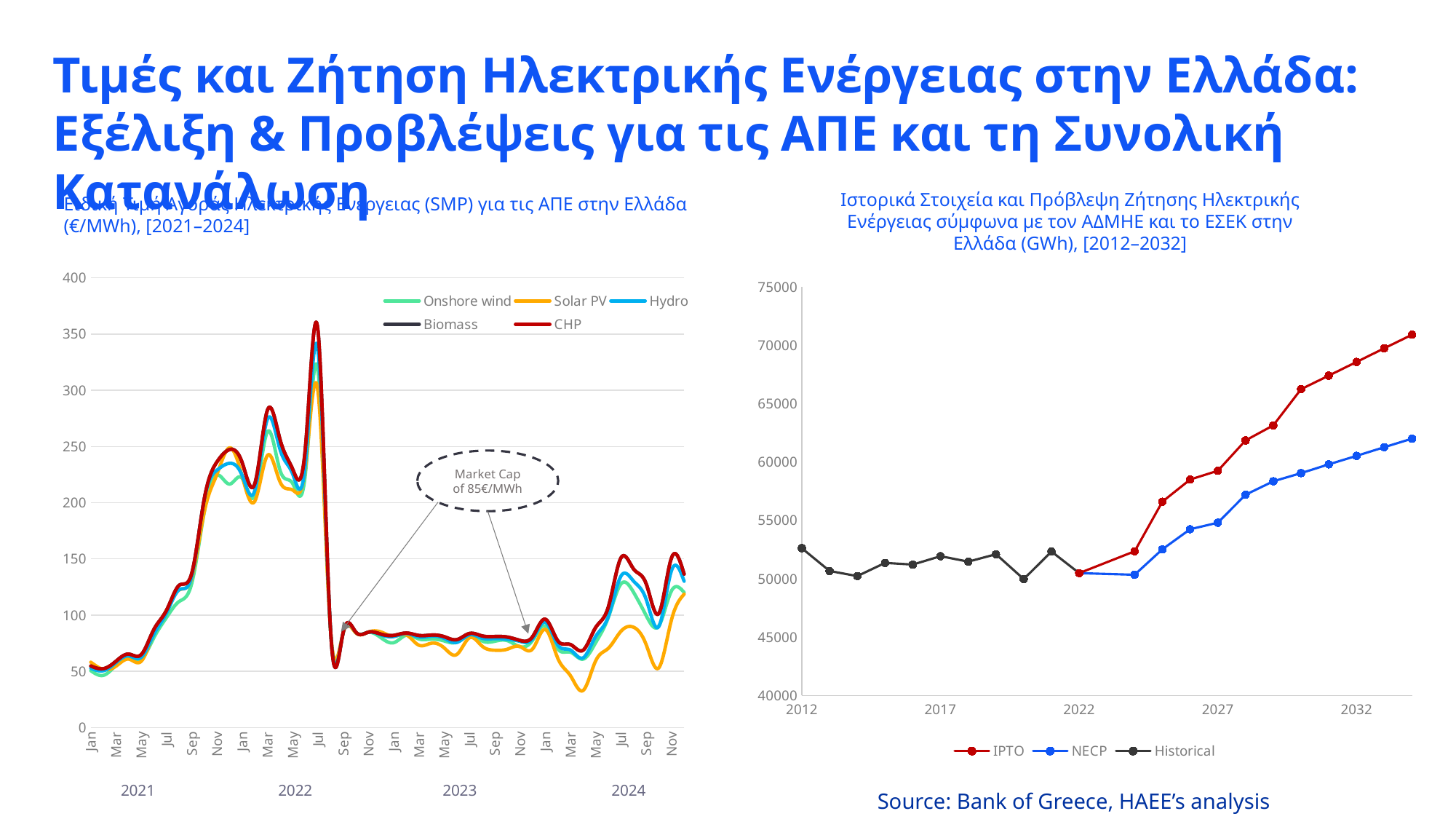
On the left chart (SMP prices), which series has the lowest value in Apr 2024? Solar PV On the left chart (SMP prices), is the value for Solar PV in Apr 2024 greater or less than 50? less What kind of chart is the right chart showing electricity demand in Greece (GWh)? Line chart On the right chart (electricity demand), which series is higher in 2030, IPTO or NECP? IPTO On the left chart (SMP prices), what market cap value is called out in the annotation? 85€/MWh On the right chart (electricity demand), is the IPTO value for 2027 greater or less than 55000? greater On the right chart (electricity demand), does the IPTO series rise or fall from 2022 to 2032? Rise How many series does the legend of the right chart (electricity demand) list? 3 What kind of chart is the left chart showing SMP prices for RES in Greece? Line chart On the left chart (SMP prices), is the peak value of CHP in Jul 2022 greater or less than 300? greater How many series does the legend of the left chart (SMP prices) list? 5 On the left chart (SMP prices), do the prices rise or fall from Jan 2021 to Nov 2021? Rise